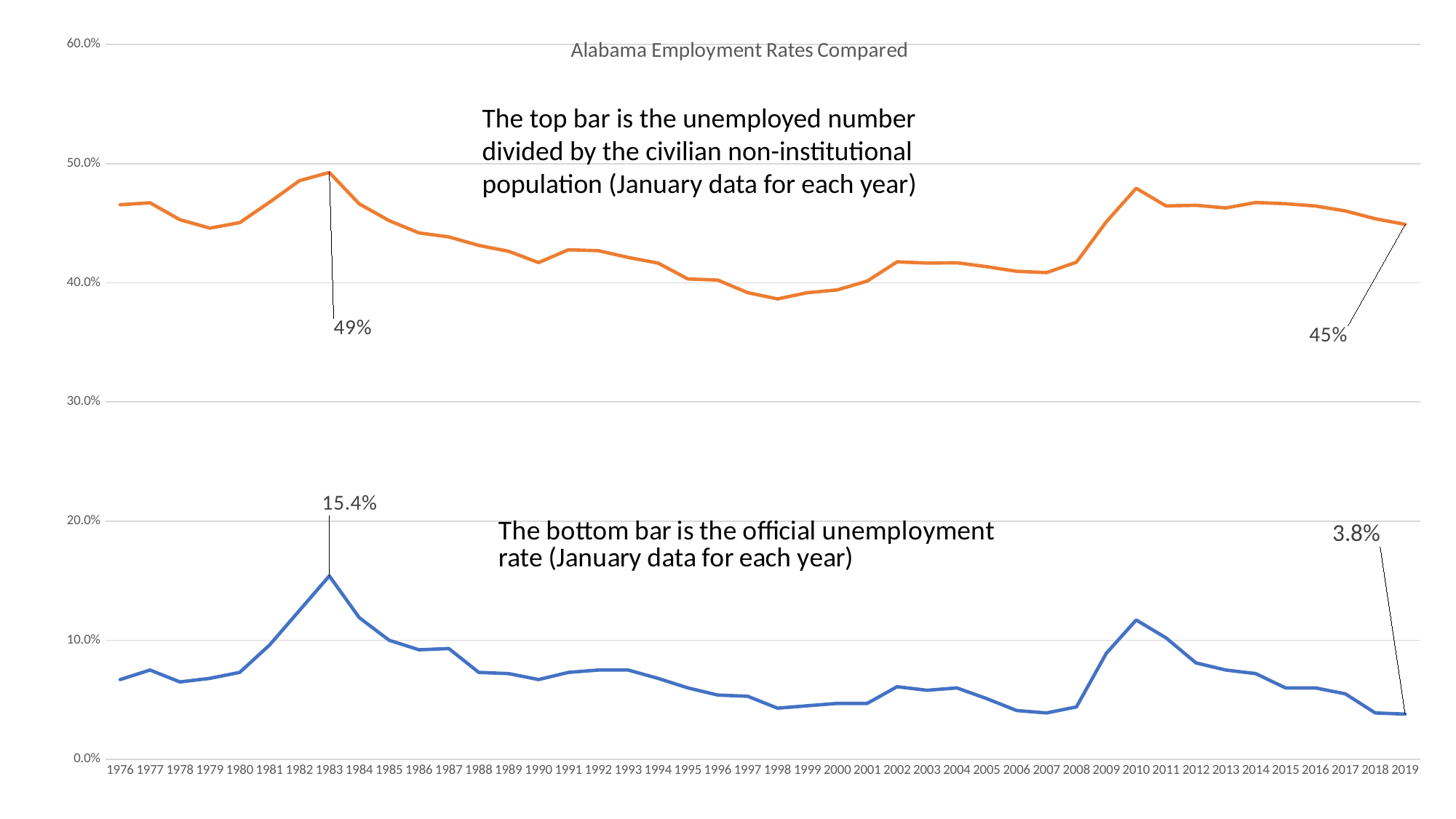
What value is labelled on the top line (unemployed divided by civilian non-institutional population) for 1983? 49% What is the title of the chart? Alabama Employment Rates Compared How many years are shown on the x axis? 44 Is the official unemployment rate (bottom line) for 2010 greater or less than 10.0%? greater In which year does the top line reach its lowest point? 1998 What is the official unemployment rate (bottom line) labelled for 1983? 15.4% By how many percentage points does the labelled official unemployment rate for 1983 exceed the labelled rate for 2019? 11.6 percentage points What kind of chart is shown on the slide? line chart What is the official unemployment rate (bottom line) labelled for 2019? 3.8% Does the official unemployment rate (bottom line) rise or fall from 2010 to 2019? fall What value is labelled on the top line for 2019? 45% In which year does the official unemployment rate (bottom line) reach its highest point? 1983